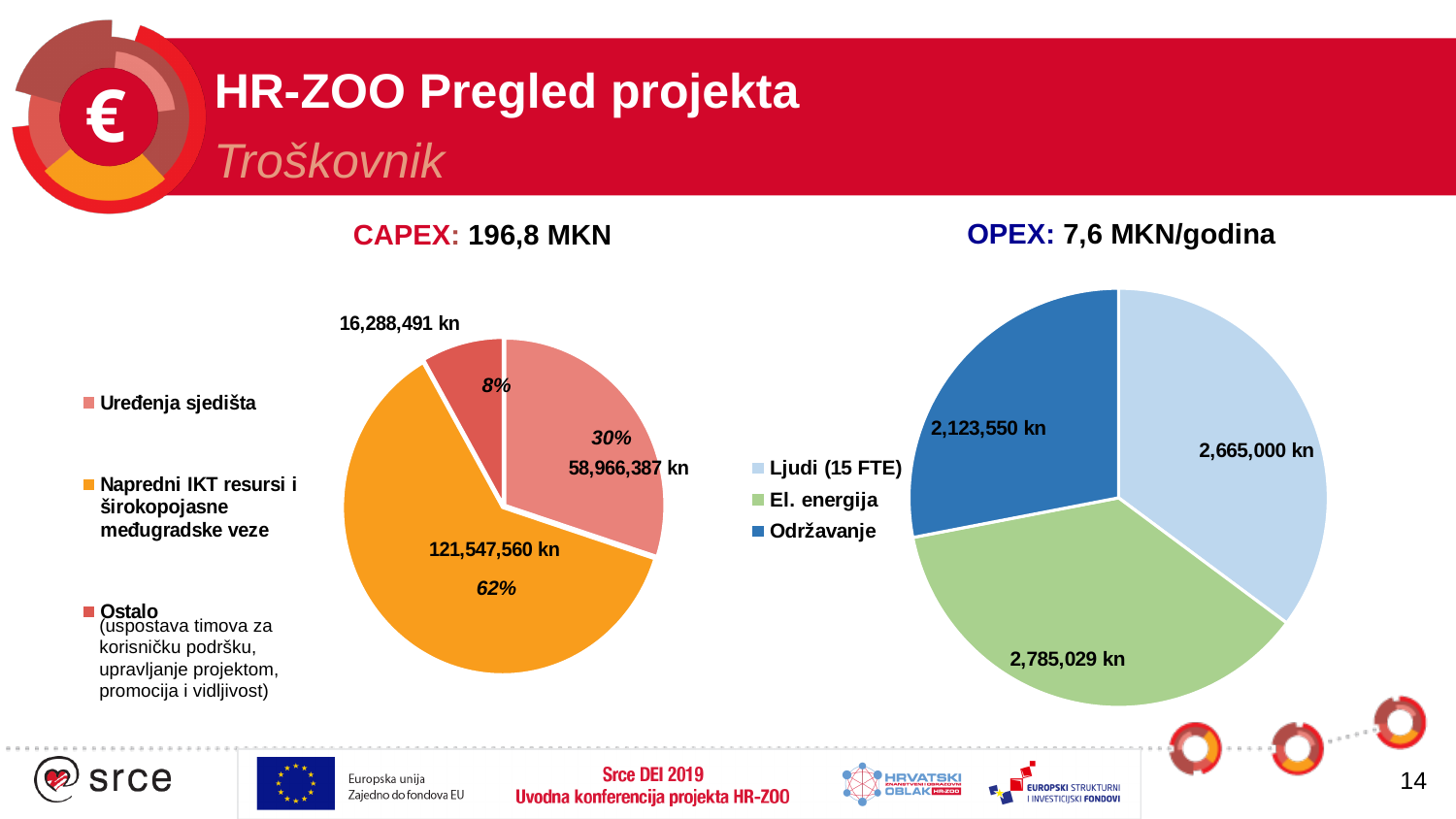
In the OPEX pie chart, what is the value for El. energija? 2,785,029 kn In the OPEX pie chart, what is the difference between Ljudi (15 FTE) and Održavanje? 541,450 kn In the OPEX pie chart, what is the value for Održavanje? 2,123,550 kn In the CAPEX pie chart, what is the value for Ostalo? 16,288,491 kn How many categories does the CAPEX pie chart legend list? 3 In the OPEX pie chart, which colour represents Održavanje? dark blue What type of chart is used for the CAPEX breakdown on the left? pie chart In the CAPEX pie chart, what is the value for Uređenja sjedišta? 58,966,387 kn In the CAPEX pie chart, what is the difference between Napredni IKT resursi i širokopojasne međugradske veze and Uređenja sjedišta? 62,581,173 kn In the OPEX pie chart, which category has the largest value? El. energija In the CAPEX pie chart, which category has the smallest slice? Ostalo In the CAPEX pie chart, what share does Napredni IKT resursi i širokopojasne međugradske veze have? 62%